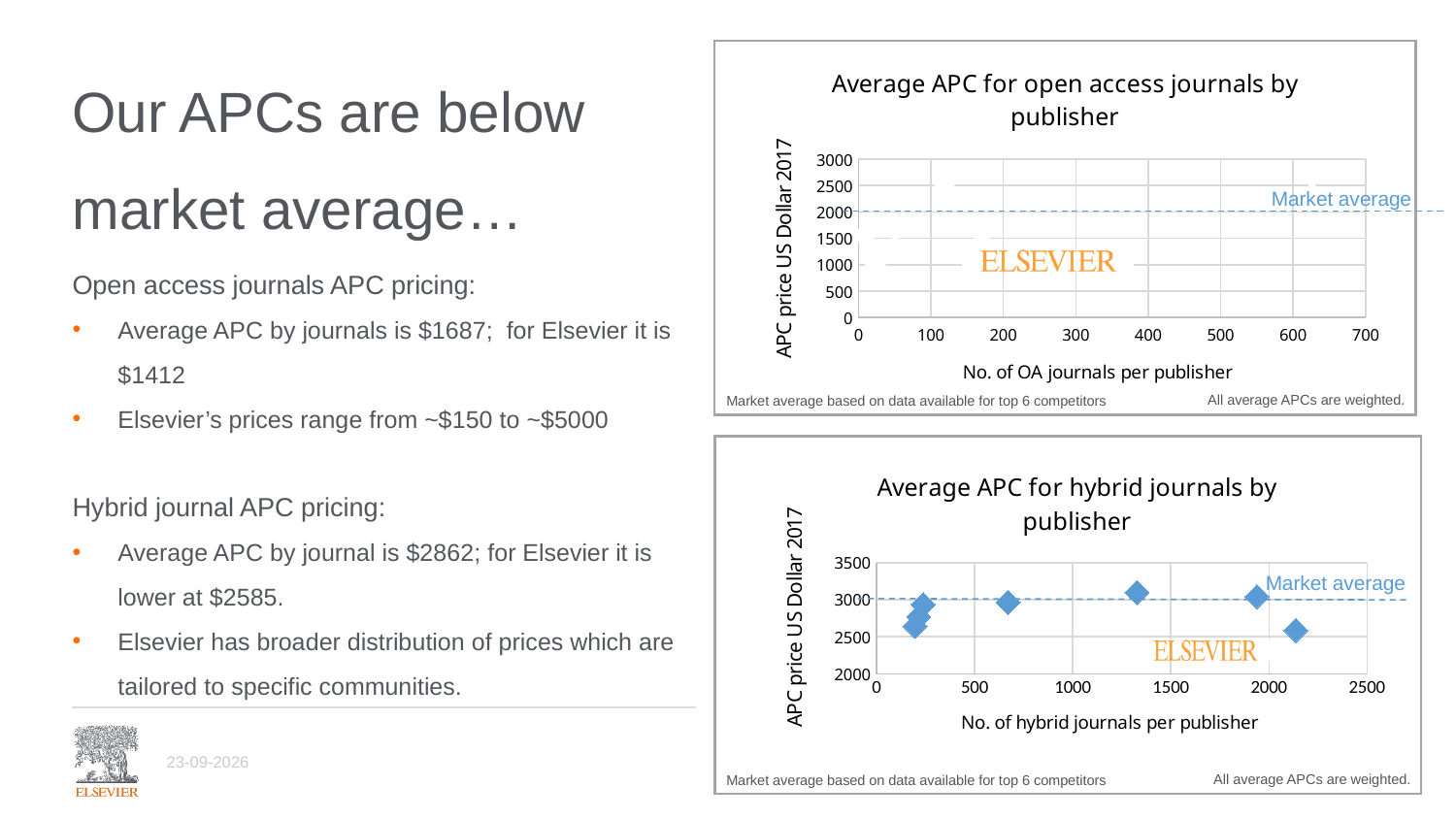
In the 'Average APC for hybrid journals by publisher' chart, is the number of hybrid journals for the rightmost point greater or less than 2000? greater In the 'Average APC for hybrid journals by publisher' chart, is the APC value for the rightmost point (the publisher with the most hybrid journals) greater or less than 3000? less What label is attached to the dashed horizontal line in the 'Average APC for hybrid journals by publisher' chart? Market average In the 'Average APC for hybrid journals by publisher' chart, which has more hybrid journals: the rightmost point or the cluster of points at the left? the rightmost point In the 'Average APC for hybrid journals by publisher' chart, is the APC value for the rightmost point greater or less than 2500? greater What is the highest value shown on the x axis of the 'Average APC for open access journals by publisher' chart? 700 What kind of chart is the 'Average APC for hybrid journals by publisher' chart? scatter chart